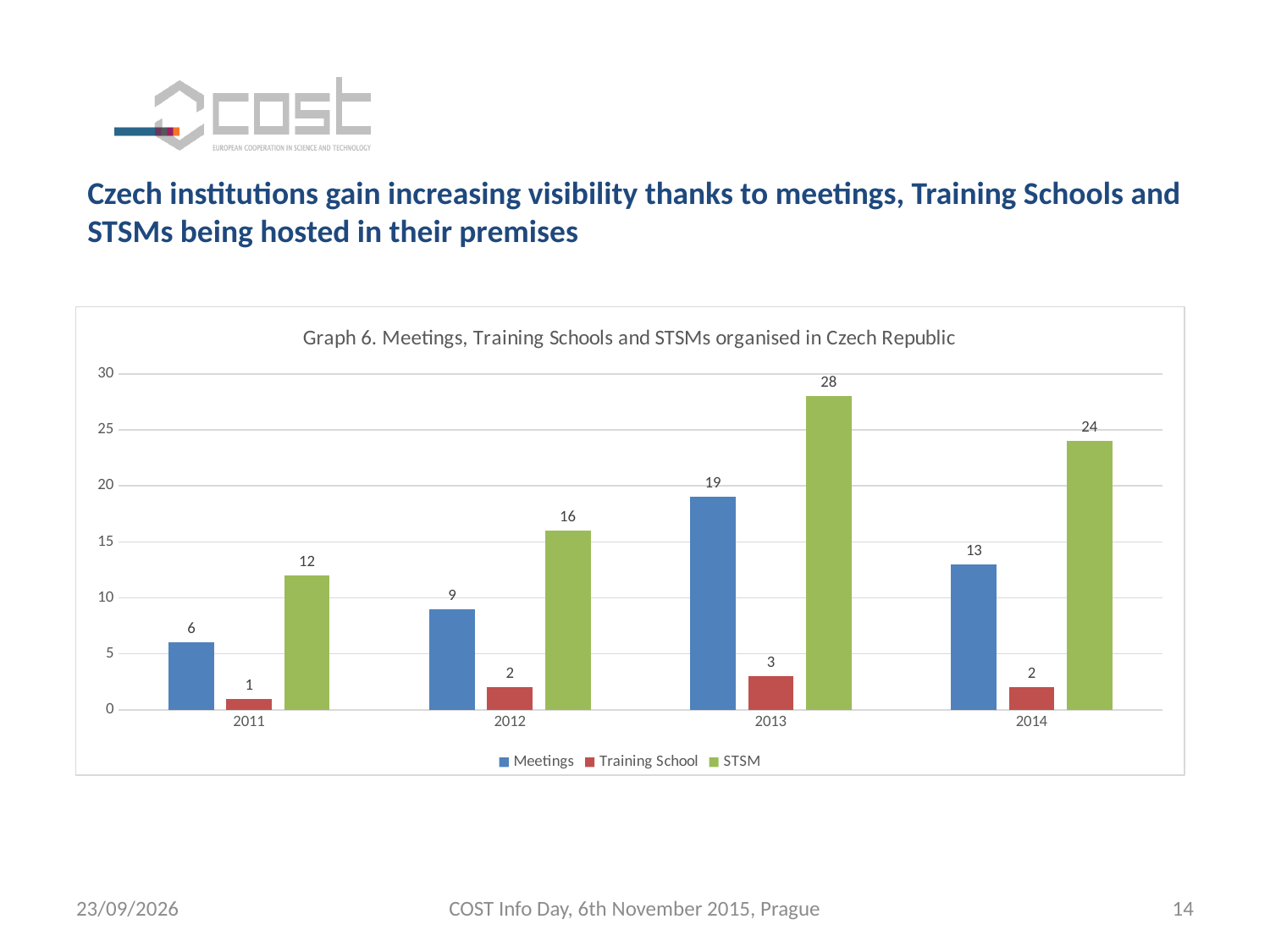
What is the difference between the STSM values for 2013 and 2014? 4 What kind of chart is this? Bar chart In which year is the STSM value highest? 2013 In which year is the Meetings value lowest? 2011 Which is larger, Meetings in 2012 or Meetings in 2014? Meetings in 2014 What is the title of the chart? Graph 6. Meetings, Training Schools and STSMs organised in Czech Republic How many years are shown on the x axis? 4 What is the value for Training School in 2013? 3 What is the value for STSM in 2011? 12 Does the STSM value rise or fall from 2011 to 2013? Rise What is the value for Meetings in 2013? 19 How many series does the legend list? 3